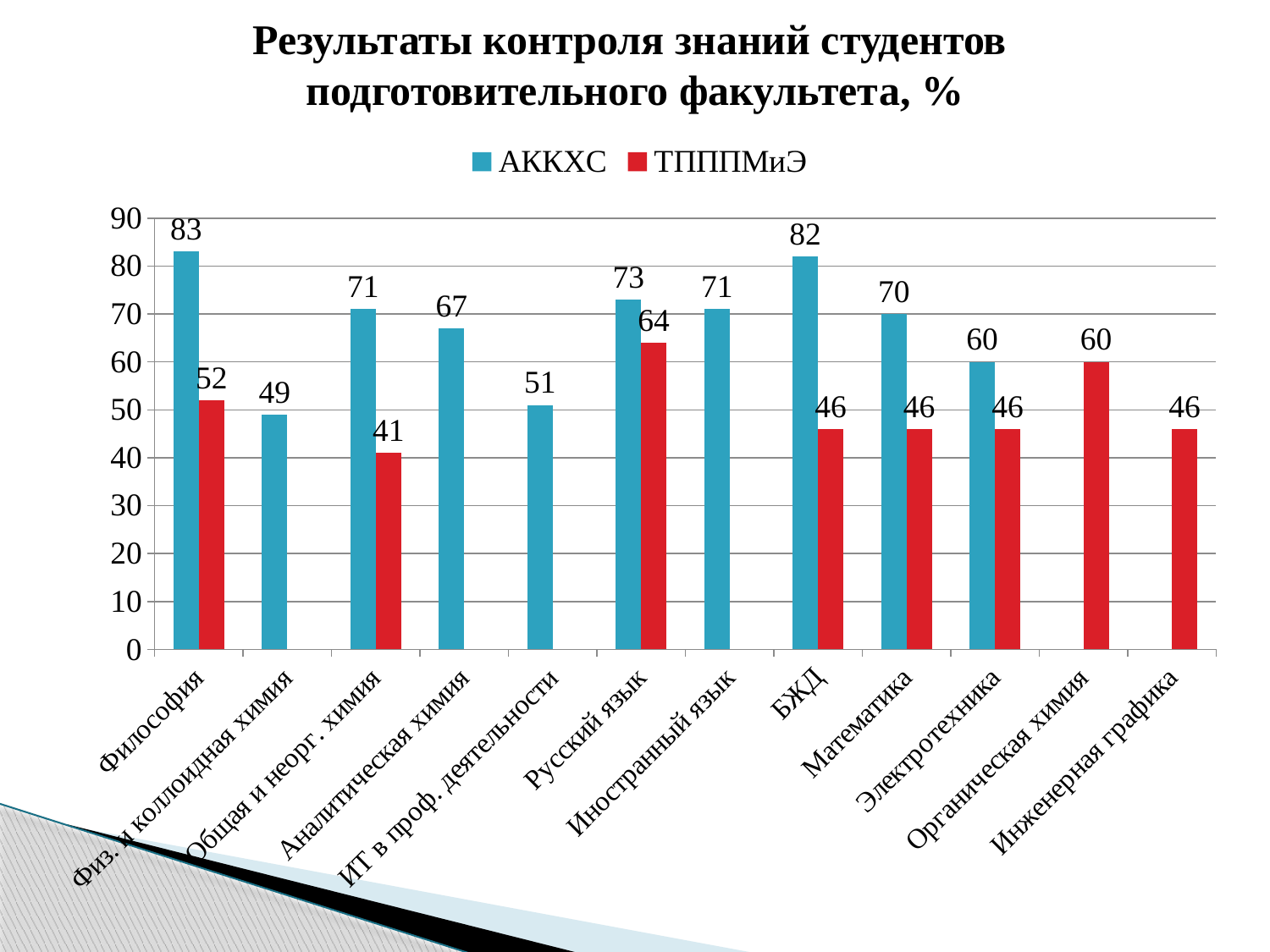
What is the title of the chart? Результаты контроля знаний студентов подготовительного факультета, % What is the difference between the АККХС and ТПППМиЭ values in БЖД? 36 What type of chart is shown on the slide? Bar chart Which category has the lowest value for АККХС? Физ. и коллоидная химия What is the value for АККХС in ИТ в проф. деятельности? 51 Which category has the lowest value for ТПППМиЭ? Общая и неорг. химия How many series does the legend list? 2 How many categories are shown on the x axis? 12 Which is larger in Математика: the АККХС value or the ТПППМиЭ value? АККХС What is the value for АККХС in Философия? 83 What is the value for ТПППМиЭ in Русский язык? 64 Which category has the highest value for АККХС? Философия